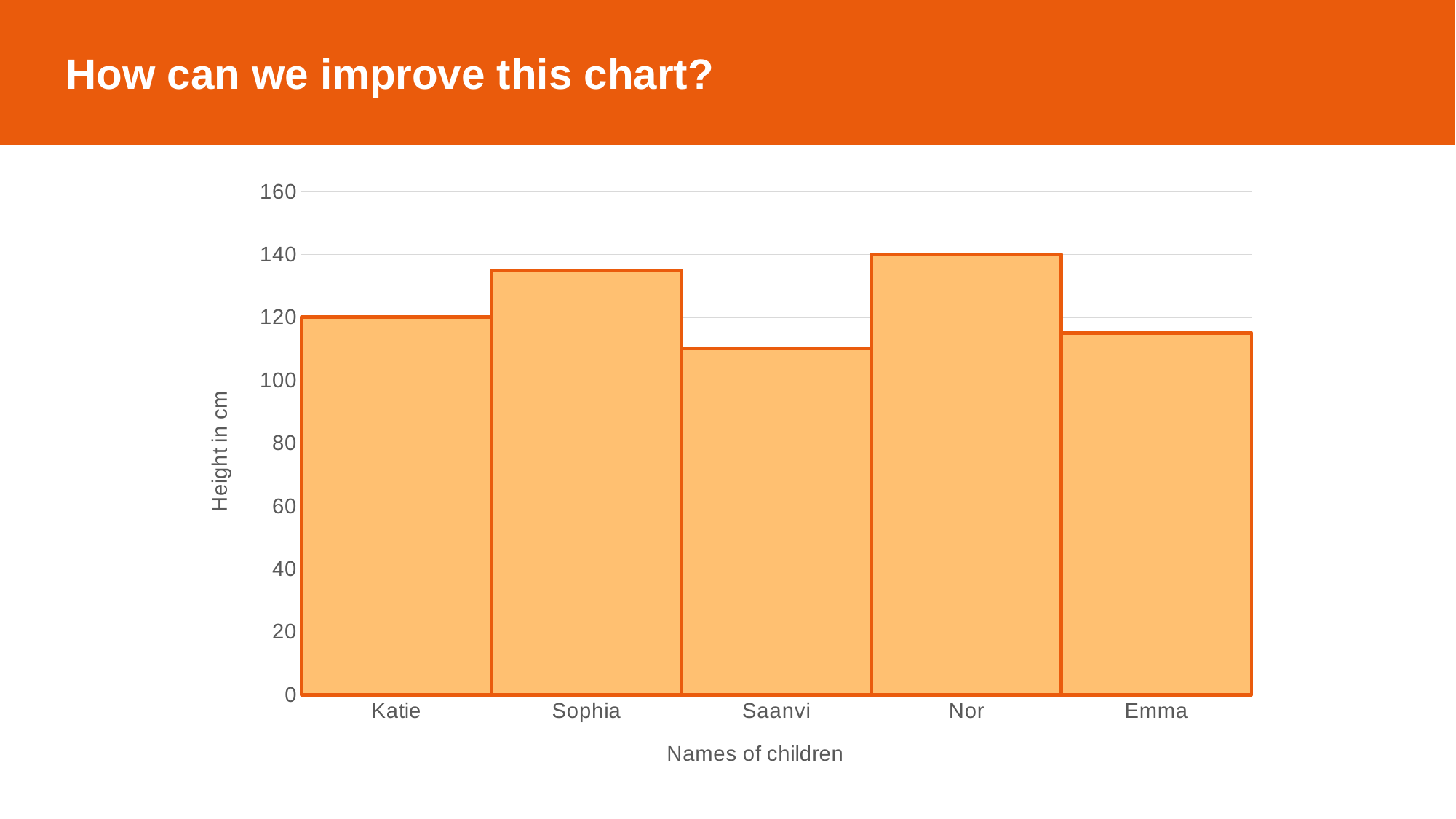
Which child has the smallest height in the chart? Saanvi How many children are shown on the x axis of the chart? 5 Who is taller, Katie or Emma? Katie Is the value for Sophia greater or less than 120? greater What is the label on the vertical axis of the chart? Height in cm Is the value for Saanvi greater or less than 120? less What is the height in cm for Nor? 140 What is the difference in height between Nor and Katie? 20 Which child has the greatest height in the chart? Nor What is the height in cm for Katie? 120 Who is taller, Sophia or Nor? Nor What type of chart is shown on the slide? Bar chart